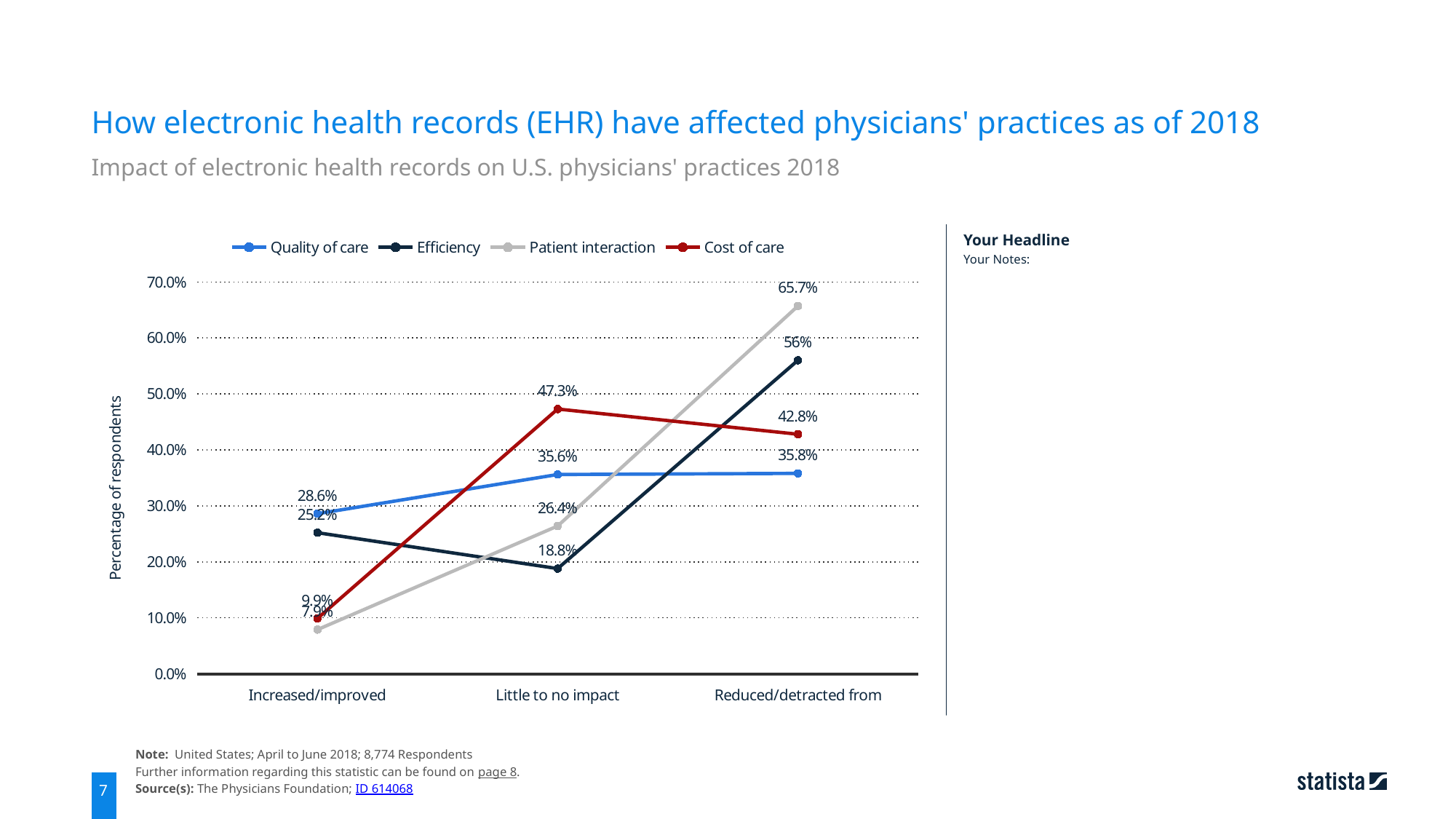
In the Increased/improved category, which is larger: Quality of care or Efficiency? Quality of care What is the value for Cost of care in the Little to no impact category? 47.3% What kind of chart is shown on the slide? line chart How many series does the legend list? 4 Does the Efficiency line rise or fall from Increased/improved to Little to no impact? fall What is the value for Quality of care in the Little to no impact category? 35.6% What is the value for Patient interaction in the Reduced/detracted from category? 65.7% What is the difference between the Cost of care values for Little to no impact and Reduced/detracted from? 4.5 percentage points In which category does Efficiency have its lowest value? Little to no impact Which series has the highest value in the Reduced/detracted from category? Patient interaction How many categories are shown on the x axis? 3 What is the value for Efficiency in the Reduced/detracted from category? 56%